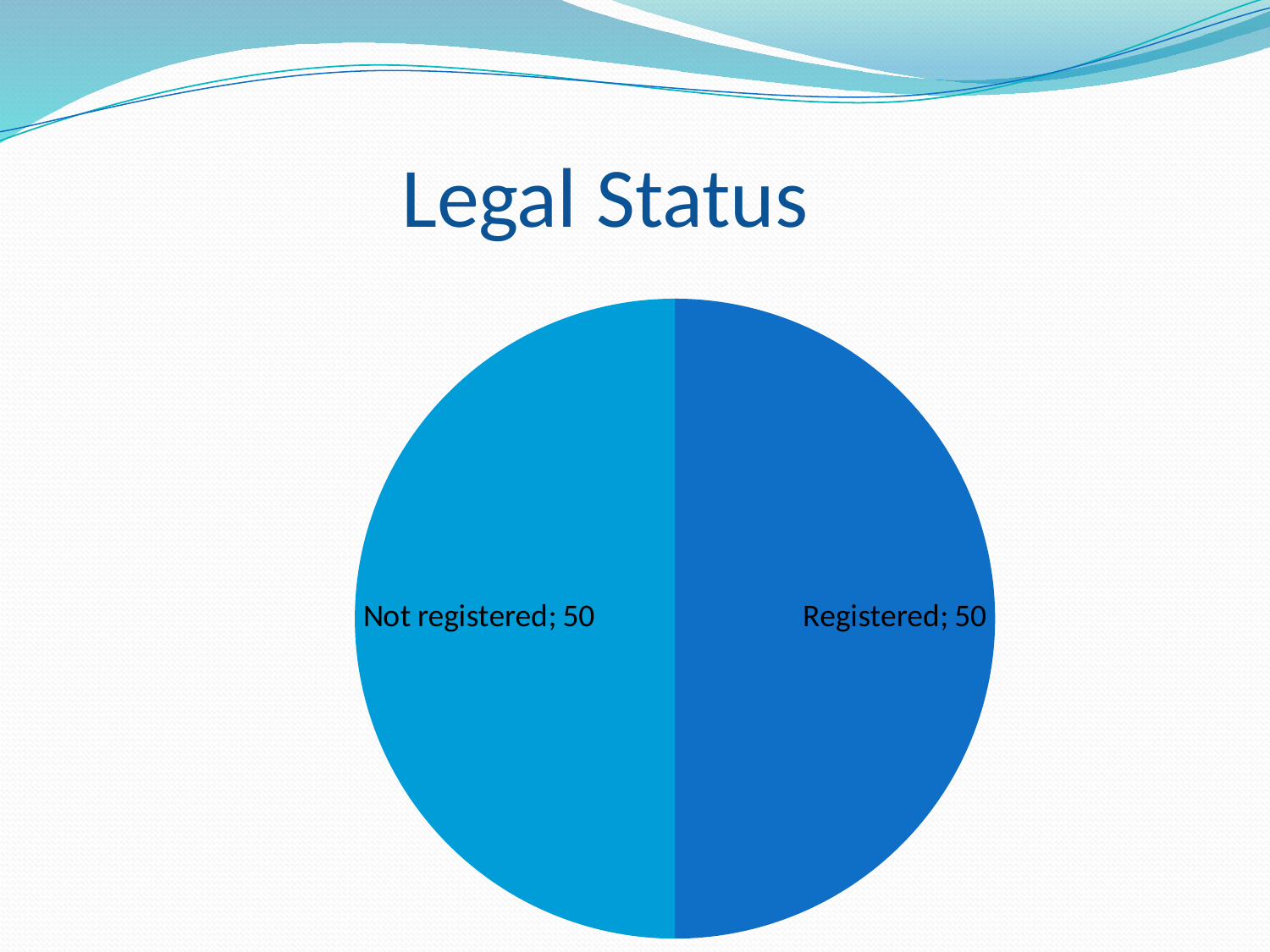
What share of the pie does the Registered slice represent? 50% What share of the pie does the Not registered slice represent? 50% Is the value for Registered greater than, less than, or equal to the value for Not registered? equal What is the total of the two slices in the pie chart? 100 What kind of chart is shown on the slide? pie chart What is the value for Registered? 50 How many slices does the pie chart have? 2 What is the title of the slide containing the pie chart? Legal Status What is the difference between the values for Registered and Not registered? 0 What is the value for Not registered? 50 Which slice is shown in the darker blue colour? Registered